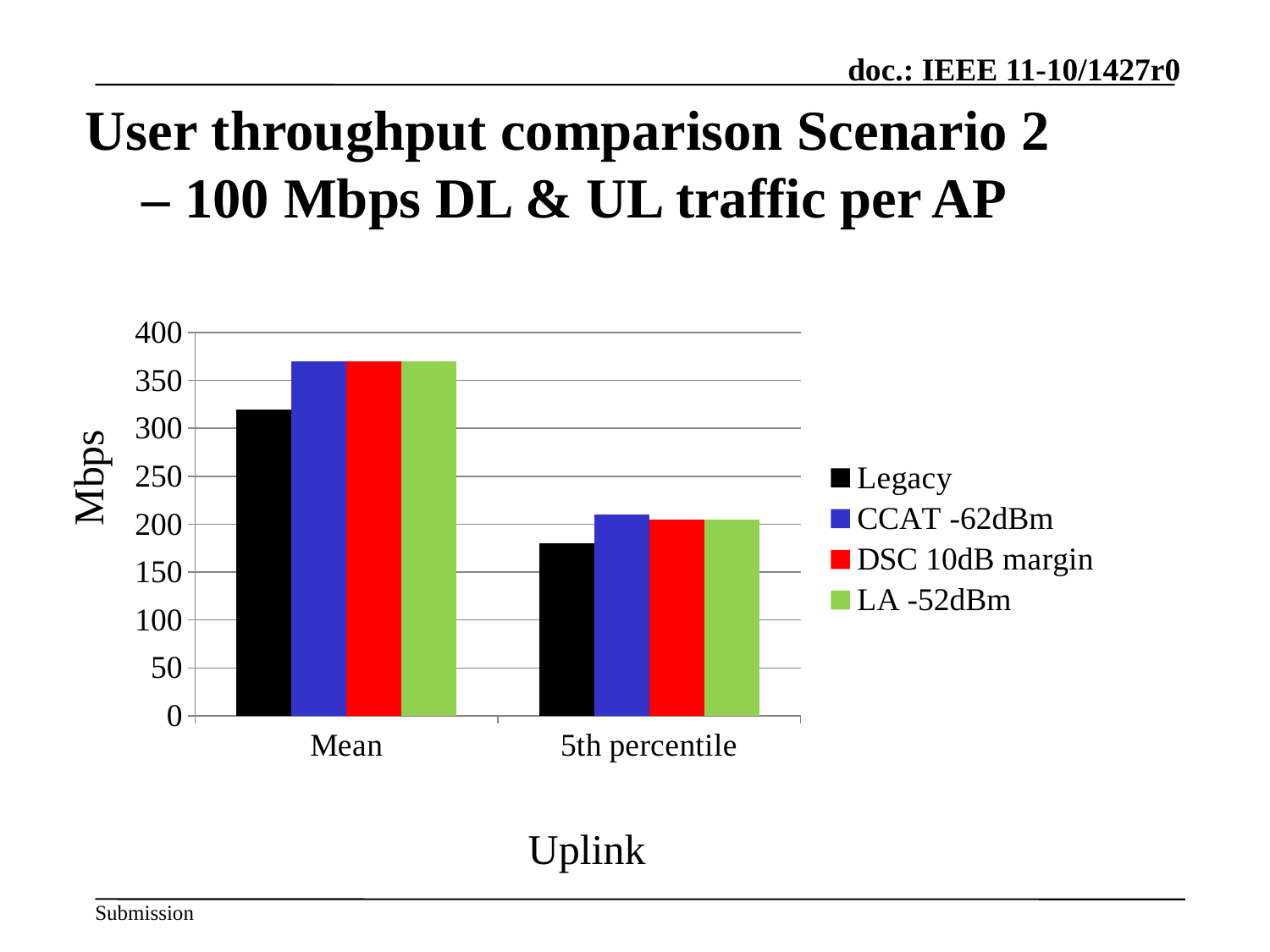
Is the value for Legacy in the 5th percentile category greater or less than 200? less What is the title shown below the x axis of the chart? Uplink Which series has the lowest value for the Mean category? Legacy How many categories are shown on the x axis of the chart? 2 Is the value for CCAT -62dBm in the Mean category greater or less than 350? greater What is the label on the y axis of the chart? Mbps How many series does the chart's legend list? 4 What kind of chart is shown on the slide? bar chart For the Mean category, which is larger: the Legacy value or the CCAT -62dBm value? CCAT -62dBm Which series has the lowest value for the 5th percentile category? Legacy Is the value for Legacy in the Mean category greater or less than 350? less